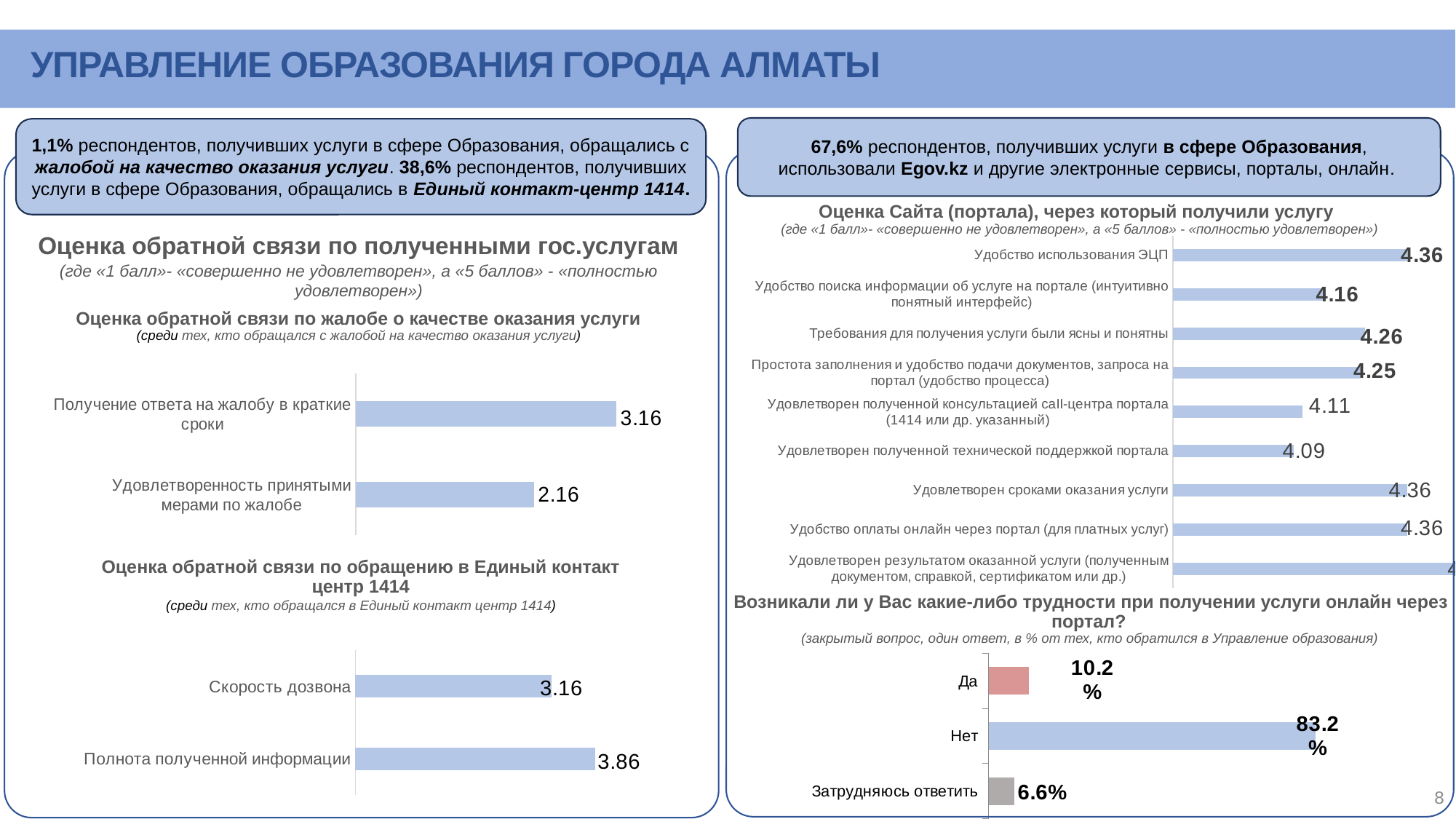
In the chart 'Оценка обратной связи по жалобе о качестве оказания услуги', what is the value for 'Удовлетворенность принятыми мерами по жалобе'? 2.16 In the chart 'Возникали ли у Вас какие-либо трудности при получении услуги онлайн через портал?', what is the value for 'Нет'? 83.2% In the chart 'Оценка обратной связи по обращению в Единый контакт центр 1414', what is the value for 'Полнота полученной информации'? 3.86 In the chart 'Оценка Сайта (портала), через который получили услугу', what is the difference between 'Требования для получения услуги были ясны и понятны' and 'Удобство поиска информации об услуге на портале (интуитивно понятный интерфейс)'? 0.10 What type of chart is 'Возникали ли у Вас какие-либо трудности при получении услуги онлайн через портал?'? Bar chart In the chart 'Оценка Сайта (портала), через который получили услугу', what is the value for 'Удовлетворен полученной консультацией call-центра портала (1414 или др. указанный)'? 4.11 In the chart 'Возникали ли у Вас какие-либо трудности при получении услуги онлайн через портал?', how many categories are shown? 3 In the chart 'Оценка обратной связи по жалобе о качестве оказания услуги', what is the difference between the two values? 1.00 In the chart 'Оценка обратной связи по обращению в Единый контакт центр 1414', which category has the higher value: 'Скорость дозвона' or 'Полнота полученной информации'? Полнота полученной информации In the chart 'Оценка Сайта (портала), через который получили услугу', which category has the lowest value? Удовлетворен полученной технической поддержкой портала In the chart 'Оценка обратной связи по жалобе о качестве оказания услуги', what is the value for 'Получение ответа на жалобу в краткие сроки'? 3.16 In the chart 'Оценка Сайта (портала), через который получили услугу', what is the value for 'Удобство использования ЭЦП'? 4.36